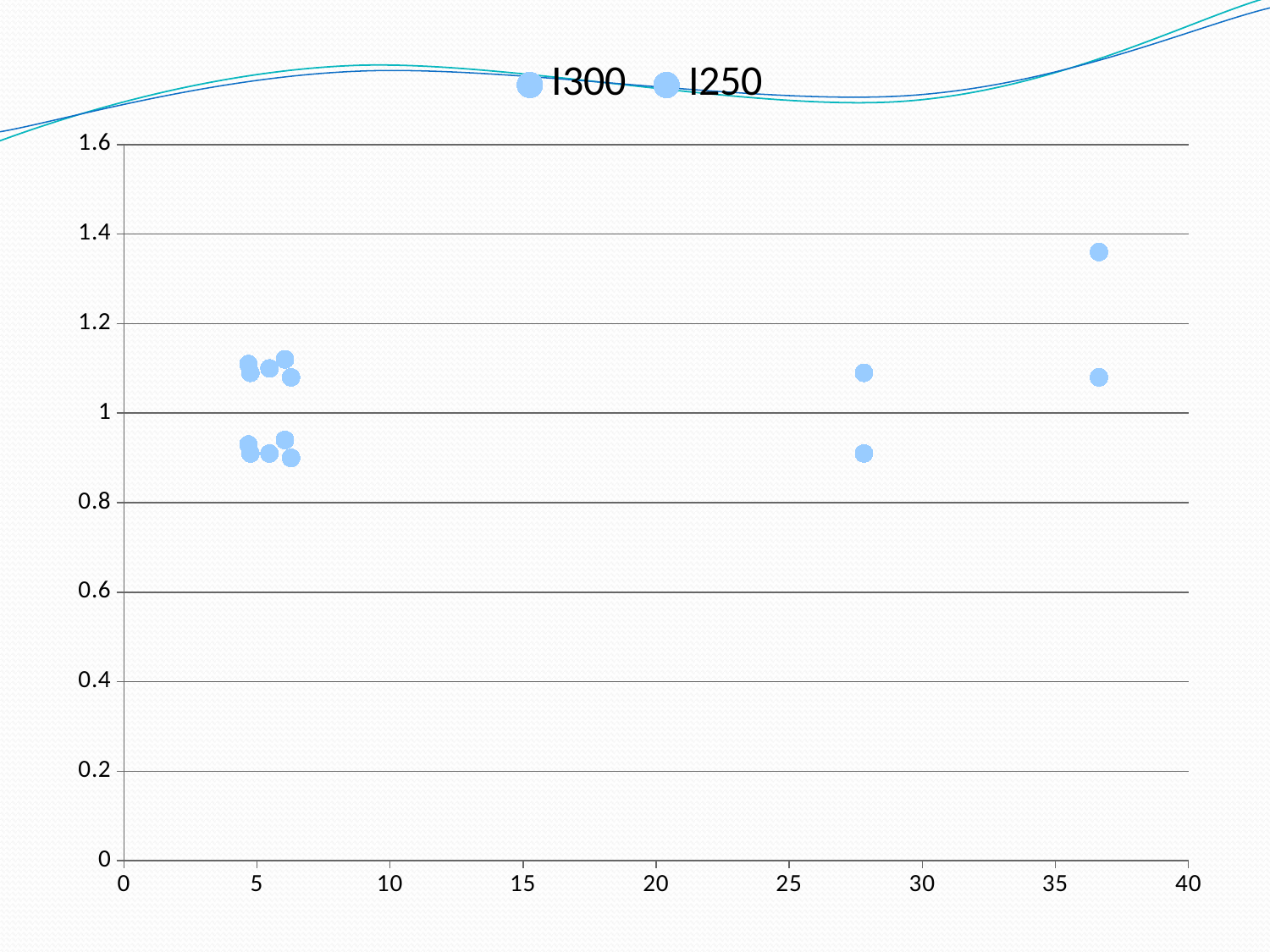
What is the maximum value shown on the vertical axis? 1.6 Is the upper point near x = 28 greater or less than 1? greater Is the lowest plotted point near x = 28 greater or less than 1? less Are the lower cluster of points near x = 5 greater or less than 0.8? greater How many series does the legend list? 2 What kind of chart is shown on the slide? scatter chart What are the two series names shown in the legend? I300 and I250 Which is larger: the upper point near x = 37 or the upper point near x = 28? the upper point near x = 37